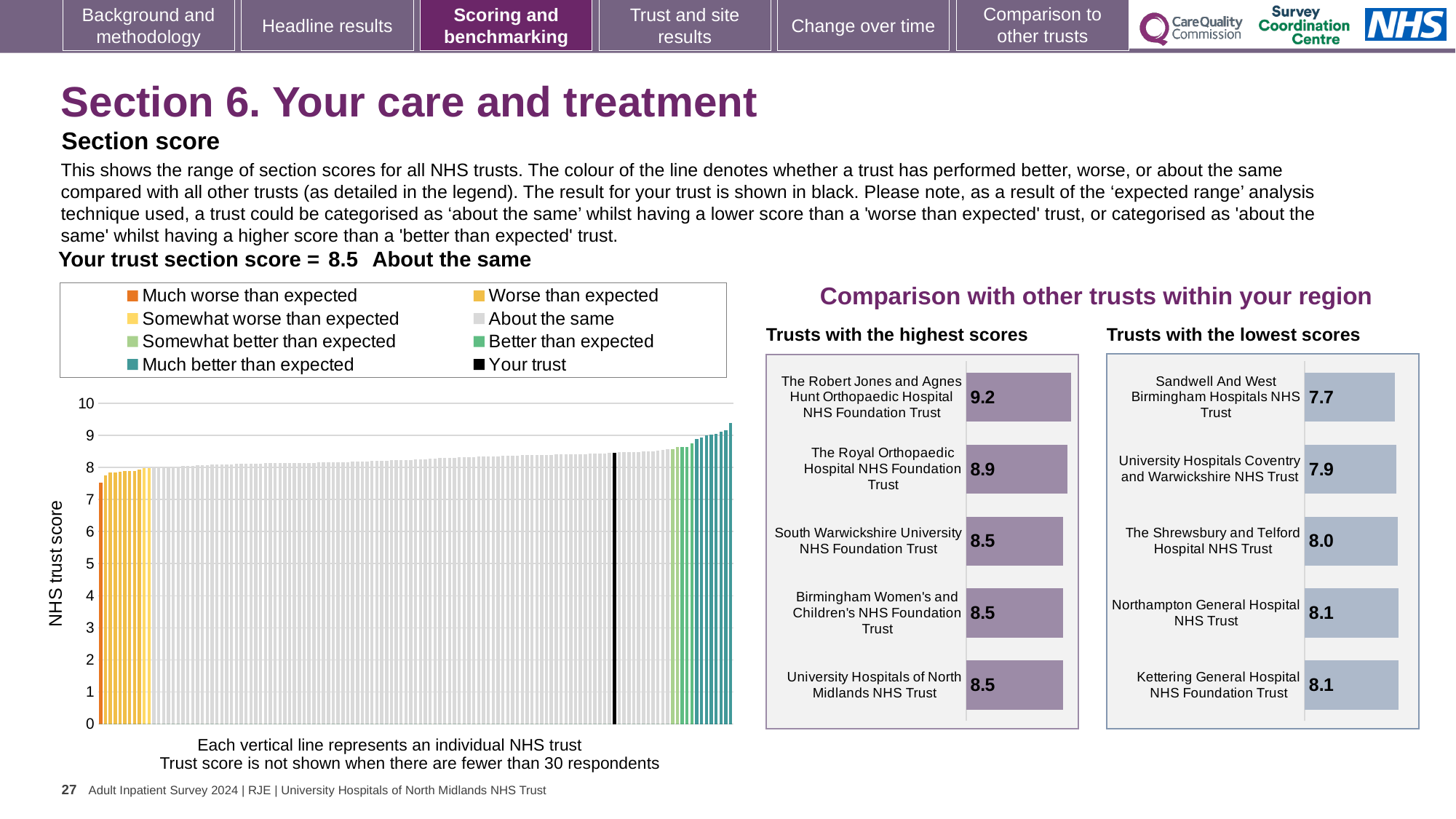
In the 'Trusts with the highest scores' chart, what is the score for The Robert Jones and Agnes Hunt Orthopaedic Hospital NHS Foundation Trust? 9.2 How many trusts are shown in the 'Trusts with the highest scores' chart? 5 In the 'Trusts with the lowest scores' chart, which trust has the lowest score? Sandwell And West Birmingham Hospitals NHS Trust In the 'NHS trust score' chart on the left, what colour is used for 'Your trust'? Black In the 'Trusts with the lowest scores' chart, what is the difference between the scores of Kettering General Hospital NHS Foundation Trust and Sandwell And West Birmingham Hospitals NHS Trust? 0.4 In the 'Trusts with the lowest scores' chart, what is the score for Sandwell And West Birmingham Hospitals NHS Trust? 7.7 How many entries does the legend of the 'NHS trust score' chart list? 8 In the 'Trusts with the lowest scores' chart, which has the larger score: University Hospitals Coventry and Warwickshire NHS Trust or The Shrewsbury and Telford Hospital NHS Trust? The Shrewsbury and Telford Hospital NHS Trust In the 'Trusts with the highest scores' chart, which trust has the highest score? The Robert Jones and Agnes Hunt Orthopaedic Hospital NHS Foundation Trust What kind of chart is the 'NHS trust score' chart on the left of the slide? Bar chart In the 'NHS trust score' chart on the left, do the bar values rise or fall from left to right? Rise In the 'Trusts with the highest scores' chart, what is the difference between the scores of The Robert Jones and Agnes Hunt Orthopaedic Hospital NHS Foundation Trust and The Royal Orthopaedic Hospital NHS Foundation Trust? 0.3